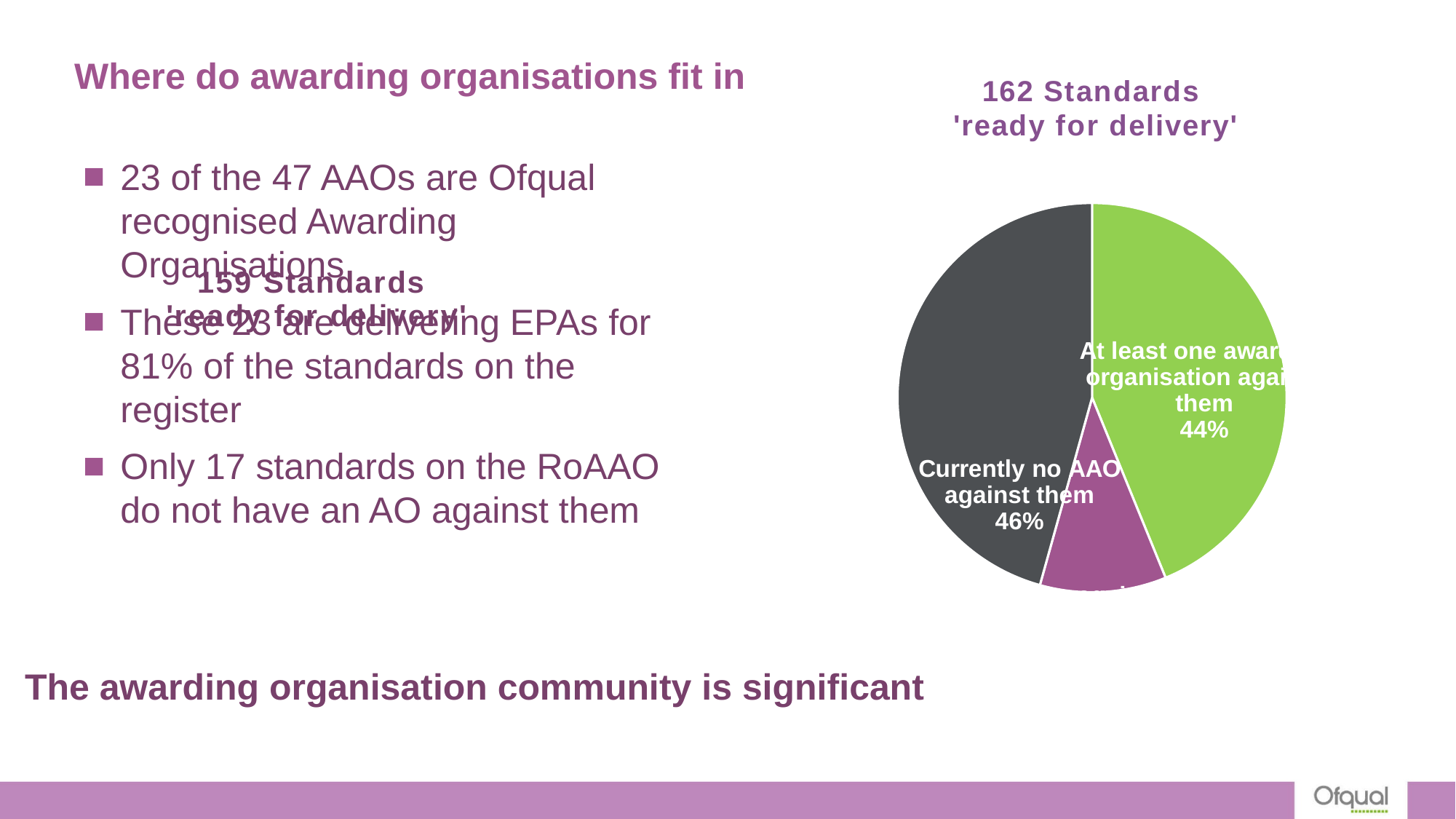
Of the two labelled slices, which has the higher percentage? Currently no AAO against them What colour is the 'Currently no AAO against them' slice? Dark grey Which is larger: the share of standards with at least one awarding organisation against them, or the share with currently no AAO against them? Currently no AAO against them What type of chart is shown on the slide? Pie chart What is the difference in percentage points between the 'Currently no AAO against them' slice and the 'At least one awarding organisation against them' slice? 2% What is the title of the pie chart? 162 Standards 'ready for delivery' Is the share of standards with currently no AAO against them greater or less than 50%? less How many slices does the pie chart have? 3 What percentage of standards have at least one awarding organisation against them? 44% What share of the pie does the 'At least one awarding organisation against them' slice represent? 44% What percentage of standards currently have no AAO against them? 46%